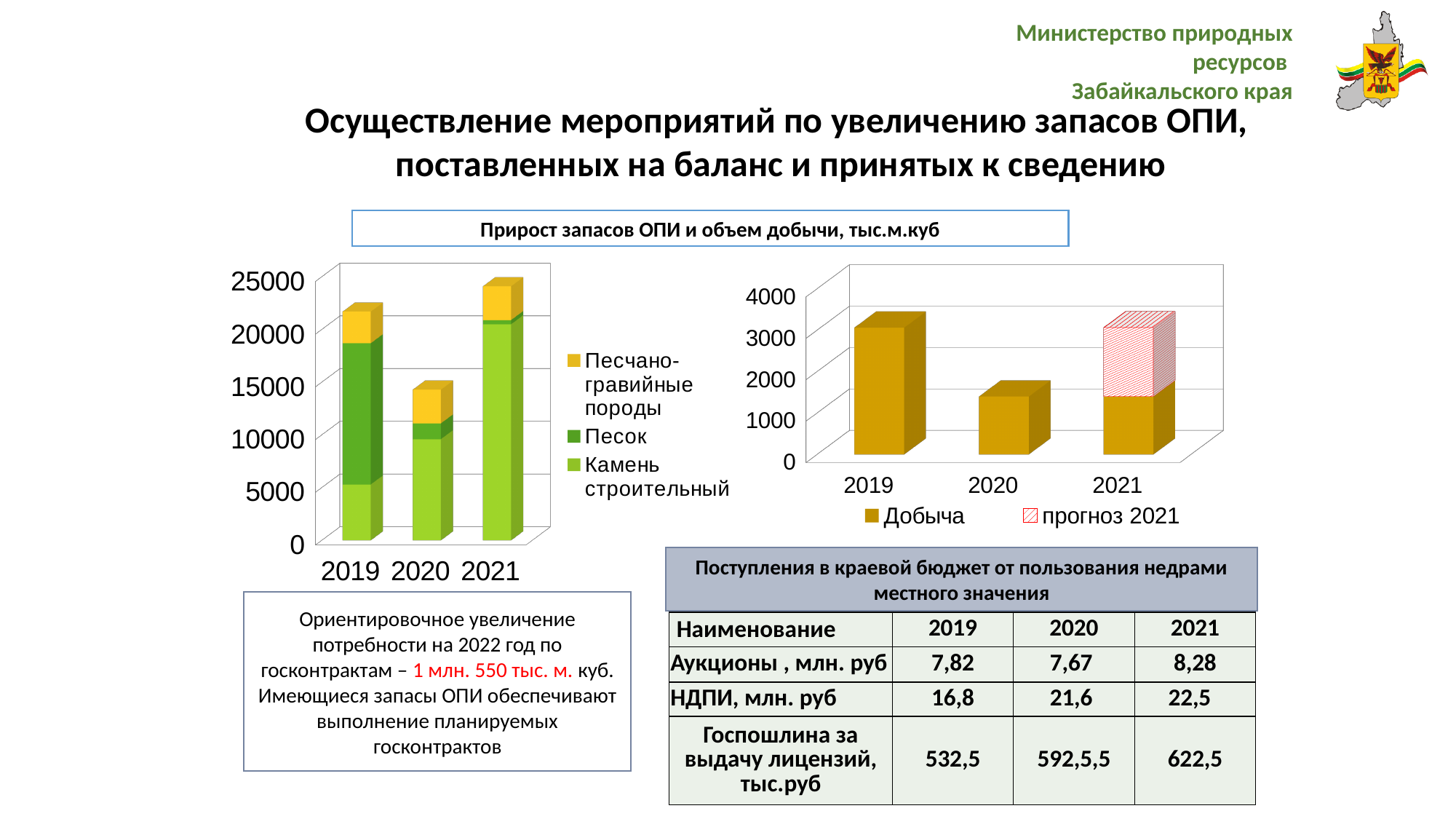
In the left chart, which year has the lowest total stacked bar? 2020 What kind of chart is the left chart on the slide? stacked bar chart In the left chart, does the Камень строительный segment rise or fall from 2019 to 2021? rises In the right chart, is the Добыча value for 2020 greater or less than 2000? less In the left chart, is the Камень строительный segment for 2021 greater or less than 15000? greater In the left chart, which year has the highest total stacked bar? 2021 How many series does the legend of the left chart list? 3 In the left chart, which year has the largest Песок segment? 2019 How many series does the legend of the right chart list? 2 In the right chart, which year has the highest Добыча bar? 2019 How many years are shown on the x axis of the left chart? 3